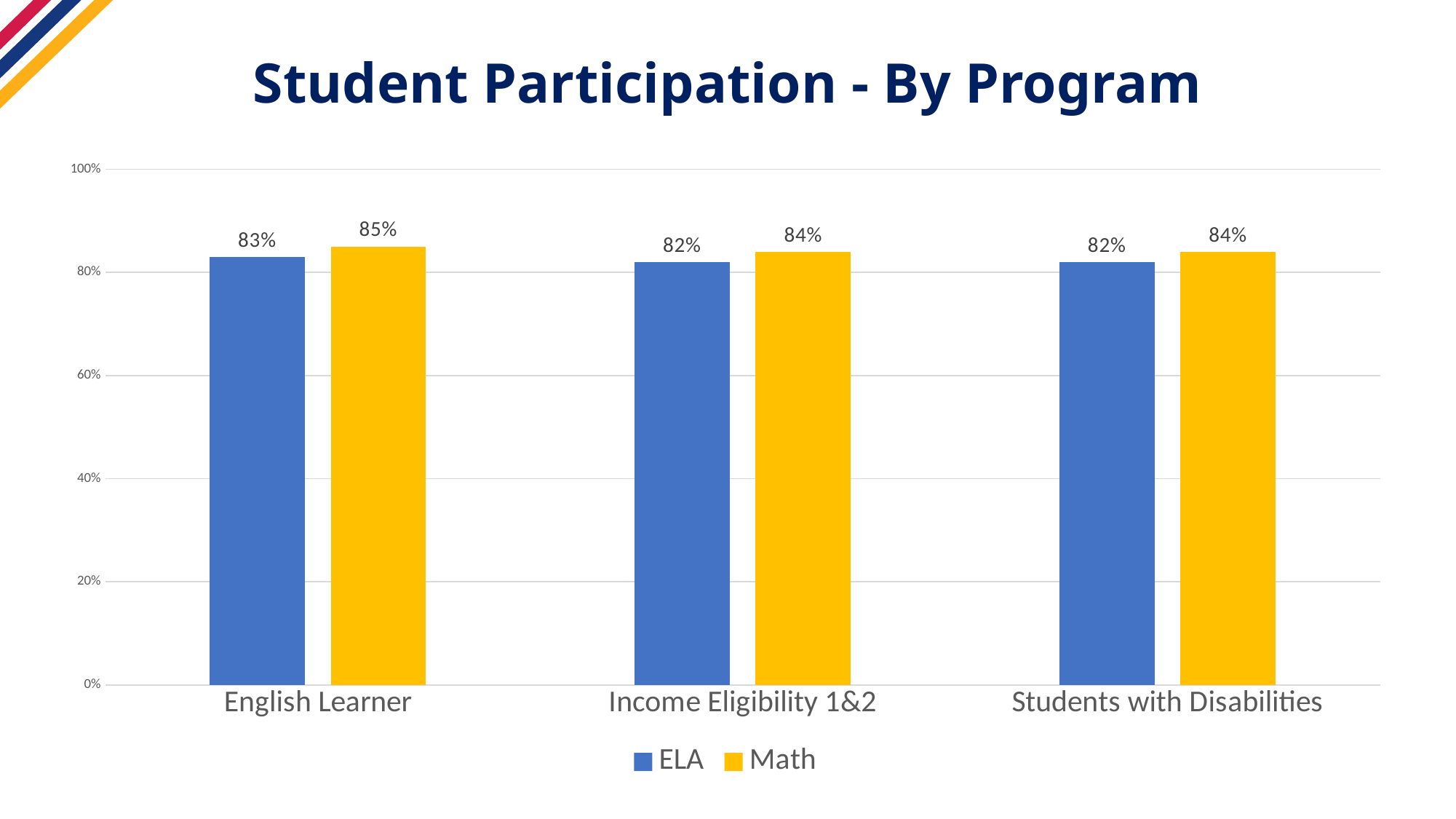
Is the ELA participation rate for Students with Disabilities greater or less than 80%? greater What is the Math participation rate for Students with Disabilities? 84% How many series does the legend list? 2 How many program categories are shown on the x axis? 3 What is the difference between the Math and ELA participation rates for English Learner? 2% What is the title of the chart? Student Participation - By Program Which program has the highest Math participation rate? English Learner What kind of chart is shown on the slide? Bar chart What is the ELA participation rate for Income Eligibility 1&2? 82% What is the difference between the Math and ELA participation rates for Income Eligibility 1&2? 2% What is the ELA participation rate for English Learner? 83% What is the Math participation rate for English Learner? 85%